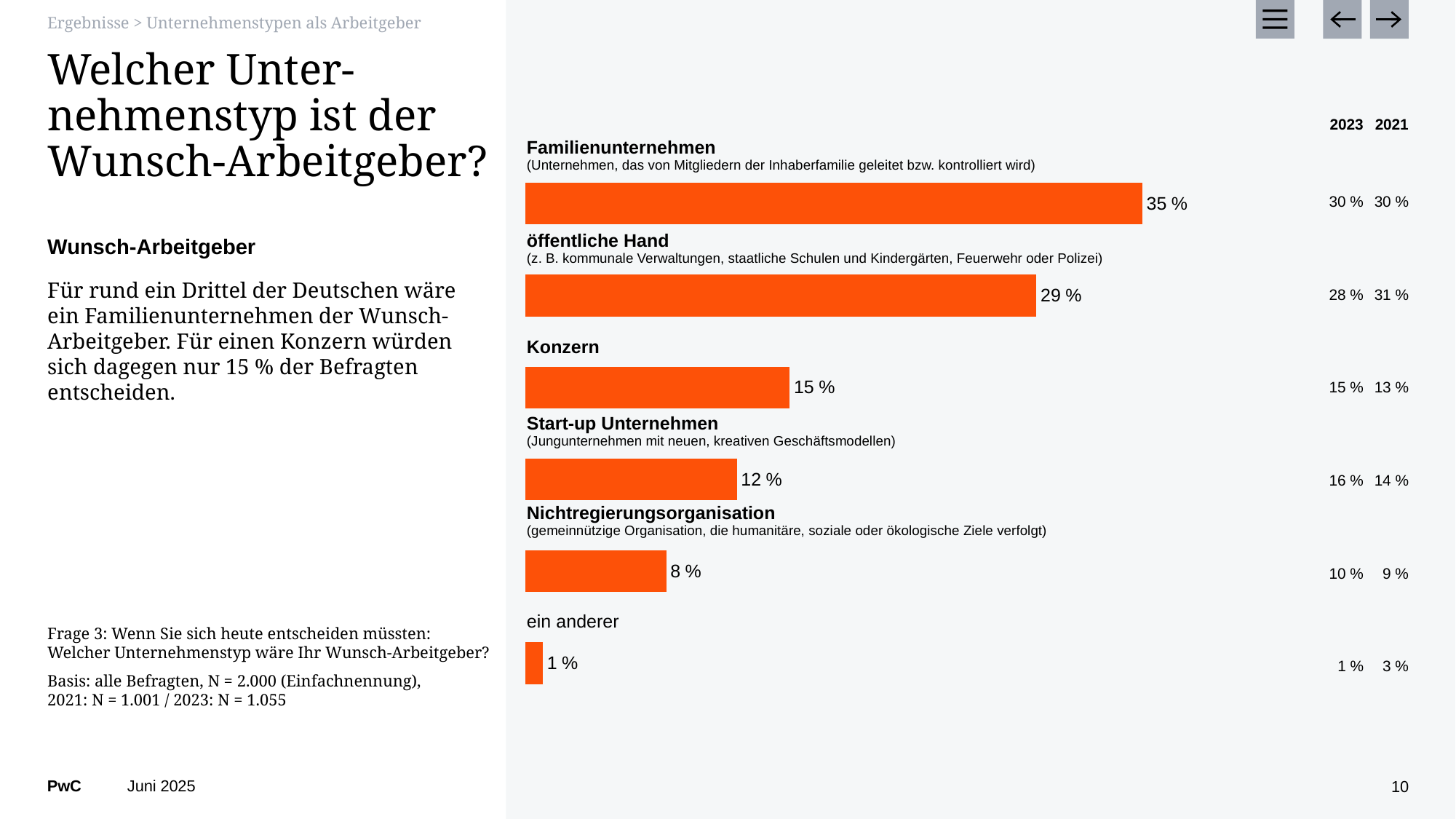
What is the value for Start-up Unternehmen in the bar chart? 12 % What was the 2021 value listed for Konzern in the column to the right of the chart? 13 % What is the difference between the values for Familienunternehmen and Konzern? 20 % What kind of chart is shown on the slide? Bar chart Which category has the highest value in the bar chart? Familienunternehmen What is the value for Nichtregierungsorganisation in the bar chart? 8 % Which category has the lowest value in the bar chart? ein anderer Which is larger, the value for öffentliche Hand or the value for Start-up Unternehmen? öffentliche Hand How many categories are shown in the bar chart? 6 What is the value for Familienunternehmen in the bar chart? 35 % What is the value for öffentliche Hand in the bar chart? 29 % What is the value for Konzern in the bar chart? 15 %